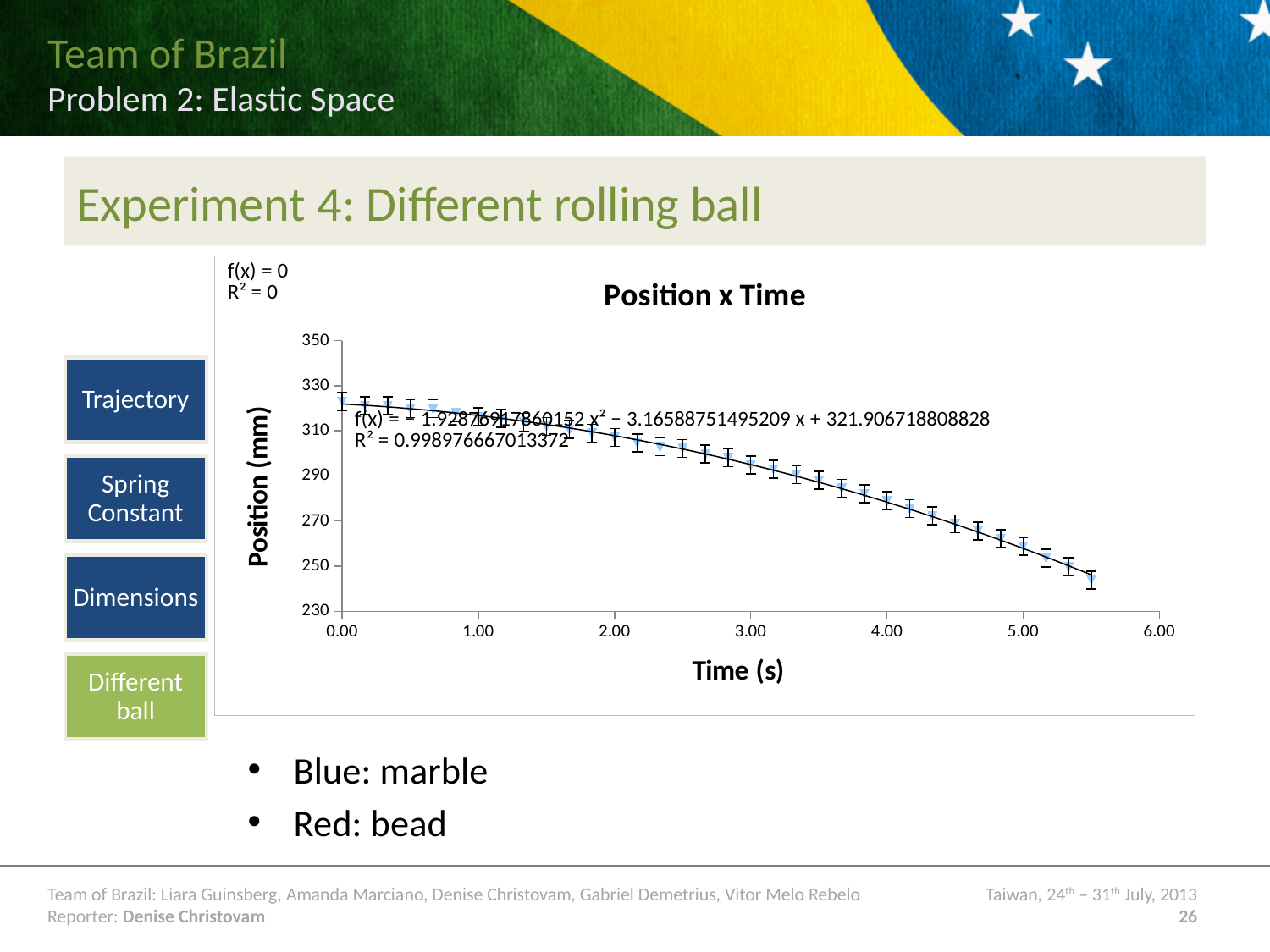
Is the position value at time 2.00 s greater or less than 290? greater Is the position value at time 4.00 s greater or less than 270? greater Which has the larger position value: the point at 1.00 s or the point at 5.00 s? the point at 1.00 s What kind of chart is shown on the slide? scatter chart Is the position value at time 4.00 s greater or less than 290? less Do the position values rise or fall as time increases along the x axis? fall What R² value is printed for the fitted trendline on the chart? 0.998976667013372 What is the label of the x axis of the chart? Time (s) At which time is the position highest? 0.00 What is the title of the chart? Position x Time